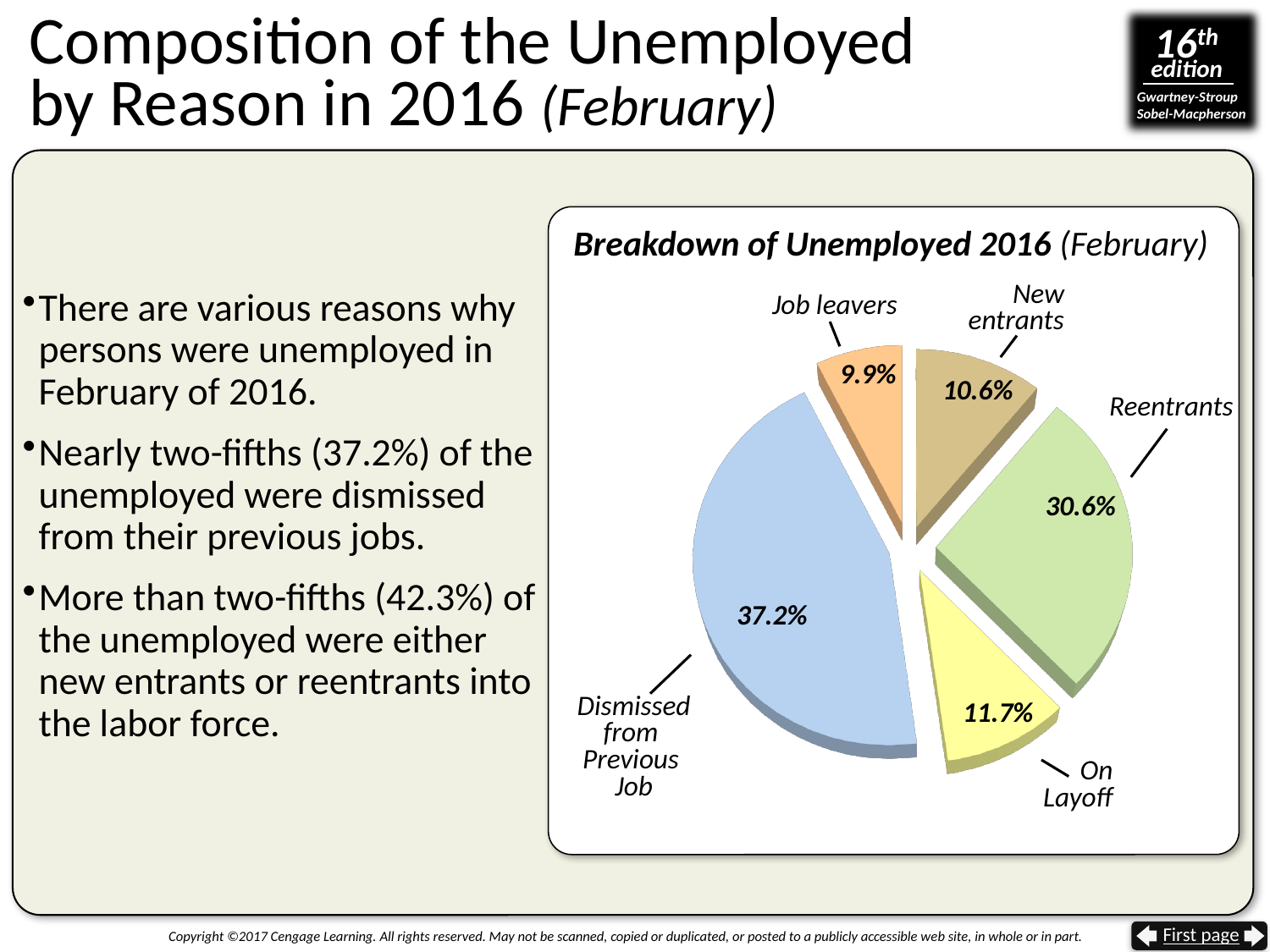
Which is larger, the share for On Layoff or the share for New entrants? On Layoff What share of the unemployed were job leavers? 9.9% Which category accounts for the smallest share of the unemployed? Job leavers What share of the unemployed were on layoff? 11.7% What is the difference in percentage points between the Dismissed from Previous Job slice and the Reentrants slice? 6.6 What share of the unemployed were reentrants? 30.6% What share of the unemployed were new entrants? 10.6% How many categories are shown in the pie chart? 5 Which category accounts for the largest share of the unemployed? Dismissed from Previous Job What kind of chart is shown on the slide? Pie chart What is the title of the chart? Breakdown of Unemployed 2016 (February) What share of the unemployed were dismissed from their previous job? 37.2%